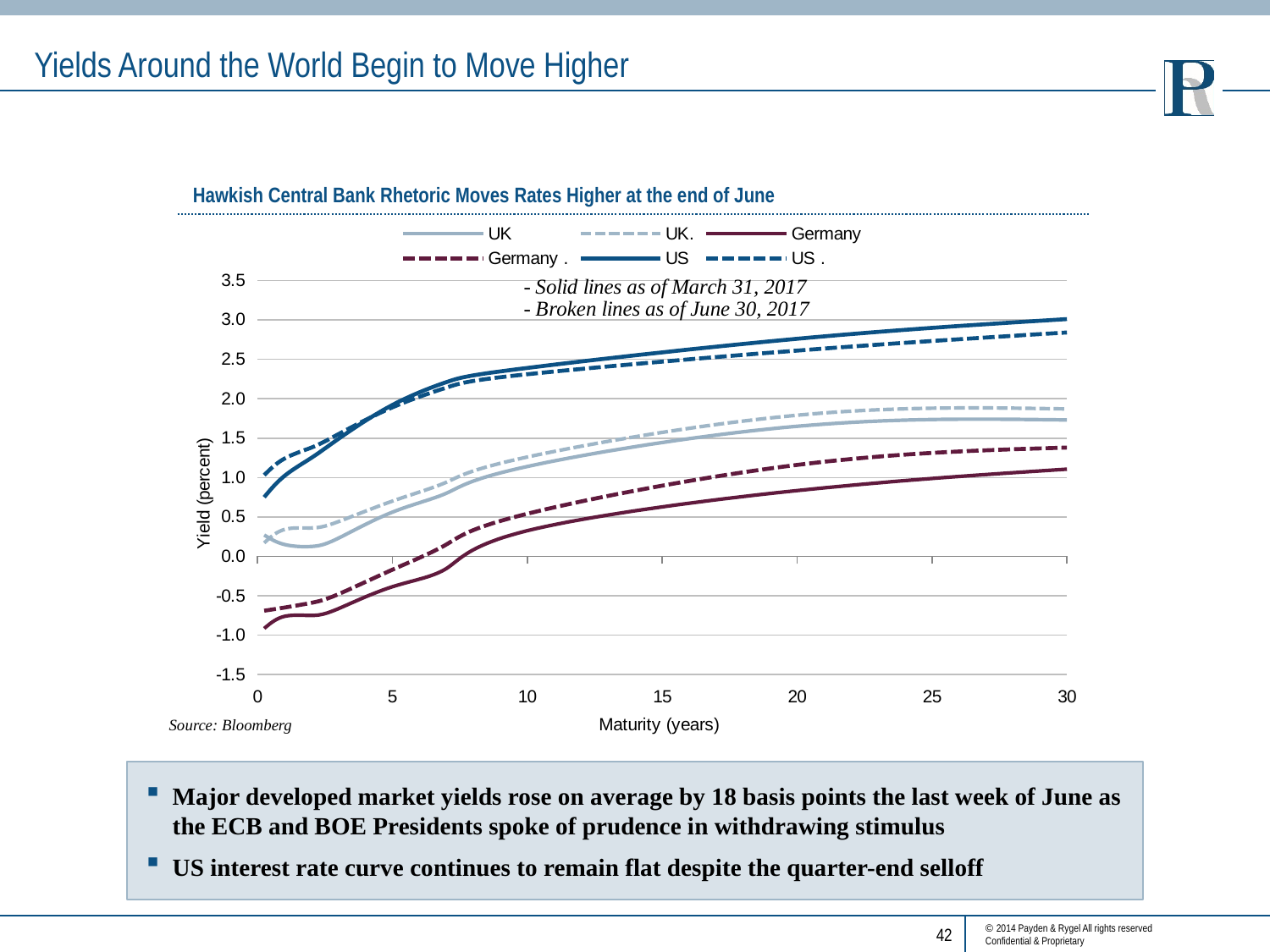
Which series has the lowest yield at a maturity of 0 years? Germany What is the label of the y axis? Yield (percent) Is the value of the broken Germany line at a maturity of 30 years greater or less than 1.0? greater Is the value of the solid US line at a maturity of 10 years greater or less than 2.0? greater Which series has the highest yield at a maturity of 30 years? US How many series does the legend list? 6 Is the value of the broken US line at a maturity of 30 years greater or less than 2.5? greater At a maturity of 30 years, which is higher: the solid Germany line or the broken Germany line? Broken Germany line What kind of chart is shown on the slide? Line chart Do the yields generally rise or fall as maturity increases? Rise What is the title of the chart? Hawkish Central Bank Rhetoric Moves Rates Higher at the end of June